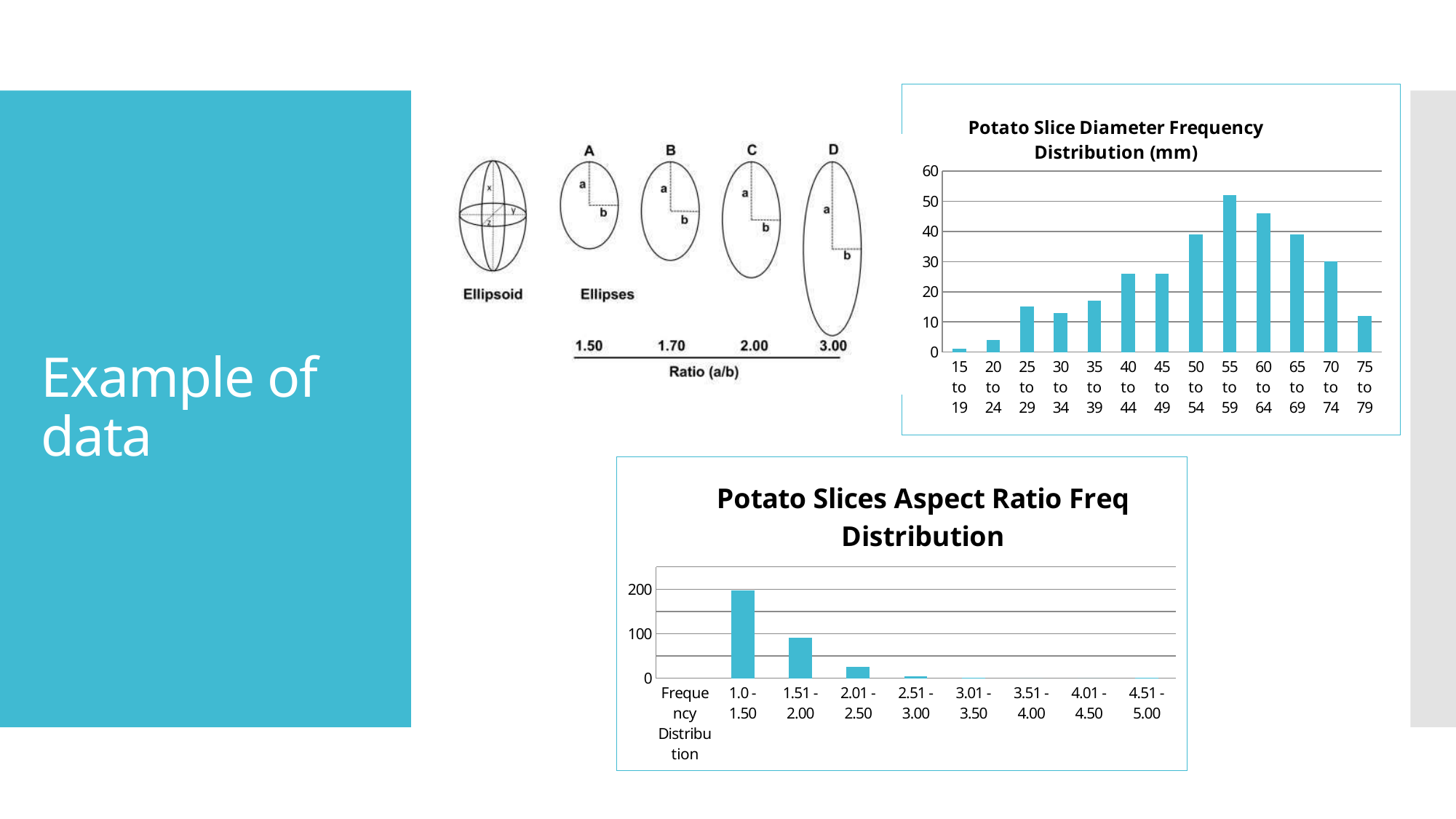
On the Potato Slice Diameter Frequency Distribution (mm) chart, is the value for 55 to 59 greater or less than 50? greater What kind of chart is the Potato Slice Diameter Frequency Distribution (mm) chart? bar chart On the Potato Slice Diameter Frequency Distribution (mm) chart, which diameter range has the lowest frequency? 15 to 19 On the Potato Slices Aspect Ratio Freq Distribution chart, which aspect ratio range has the highest frequency? 1.0 - 1.50 On the Potato Slice Diameter Frequency Distribution (mm) chart, is the value for 40 to 44 greater or less than 20? greater On the Potato Slices Aspect Ratio Freq Distribution chart, is the value for 1.51 - 2.00 greater or less than 100? less On the Potato Slices Aspect Ratio Freq Distribution chart, which has the larger value: 1.51 - 2.00 or 2.01 - 2.50? 1.51 - 2.00 On the Potato Slice Diameter Frequency Distribution (mm) chart, which has the larger value: 60 to 64 or 70 to 74? 60 to 64 On the Potato Slice Diameter Frequency Distribution (mm) chart, which diameter range has the highest frequency? 55 to 59 How many diameter ranges are shown on the Potato Slice Diameter Frequency Distribution (mm) chart? 13